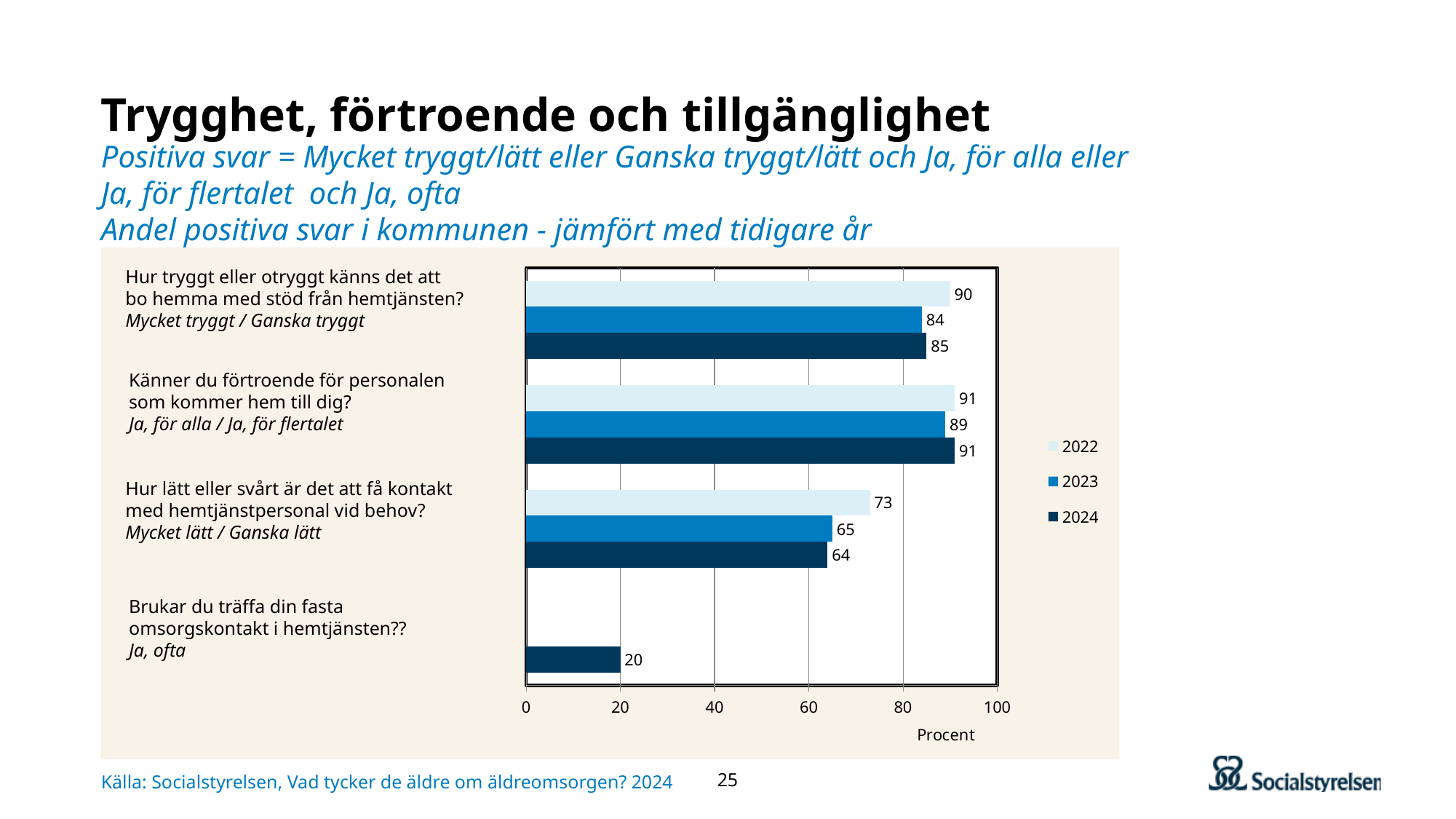
What is the 2022 value for "Hur tryggt eller otryggt känns det att bo hemma med stöd från hemtjänsten?"? 90 How many question categories are shown on the chart? 4 What is the difference between the 2022 and 2024 values for "Hur lätt eller svårt är det att få kontakt med hemtjänstpersonal vid behov?"? 9 For "Hur tryggt eller otryggt känns det att bo hemma med stöd från hemtjänsten?", which year has the larger value, 2022 or 2023? 2022 What is the 2024 value for "Känner du förtroende för personalen som kommer hem till dig?"? 91 What is the 2023 value for "Hur lätt eller svårt är det att få kontakt med hemtjänstpersonal vid behov?"? 65 How many series does the legend list? 3 What is the 2024 value for "Brukar du träffa din fasta omsorgskontakt i hemtjänsten?"? 20 What is the label on the horizontal axis of the chart? Procent Which question category has the highest 2022 value? Känner du förtroende för personalen som kommer hem till dig? What kind of chart is shown on the slide? Bar chart Which question category has the lowest 2024 value? Brukar du träffa din fasta omsorgskontakt i hemtjänsten?